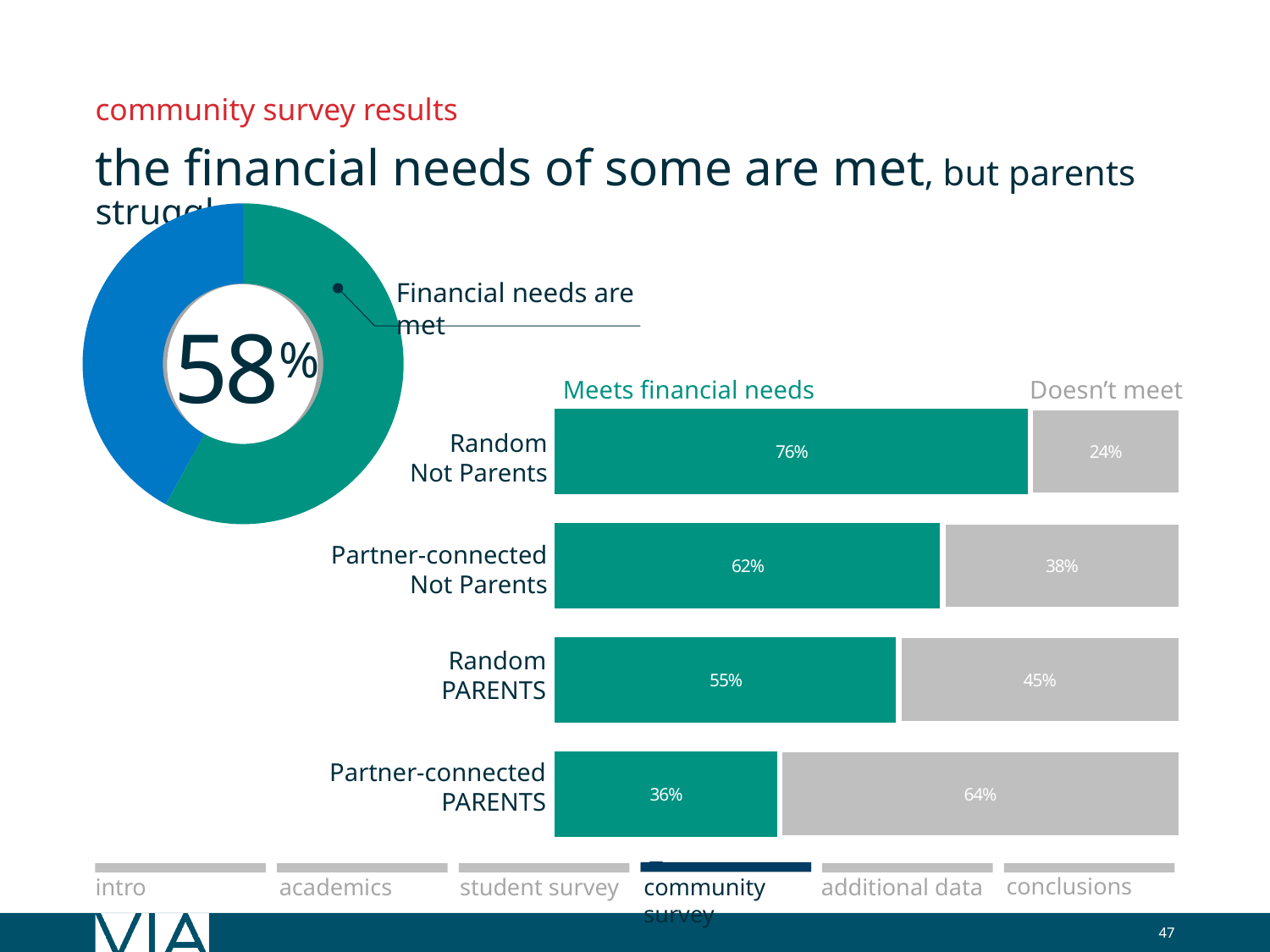
How many series does the stacked bar chart show? 2 In the stacked bar chart, which group has the lowest 'Meets financial needs' percentage? Partner-connected PARENTS In the stacked bar chart, is the 'Doesn't meet' value larger for Random PARENTS or for Partner-connected Not Parents? Random PARENTS In the stacked bar chart, what is the 'Meets financial needs' value for Random PARENTS? 55% What kind of chart is used to show the four groups on the right of the slide? Stacked bar chart How many groups are shown in the stacked bar chart? 4 In the stacked bar chart, what percentage of Random Not Parents say their financial needs are met? 76% In the stacked bar chart, what is the 'Doesn't meet' value for Partner-connected PARENTS? 64% In the stacked bar chart, what is the difference between the 'Meets financial needs' values for Random Not Parents and Partner-connected Not Parents? 14% In the stacked bar chart, what is the total of the two segments for Random PARENTS? 100% What percentage is shown in the centre of the donut chart on the left? 58% In the stacked bar chart, which group has the highest 'Meets financial needs' percentage? Random Not Parents